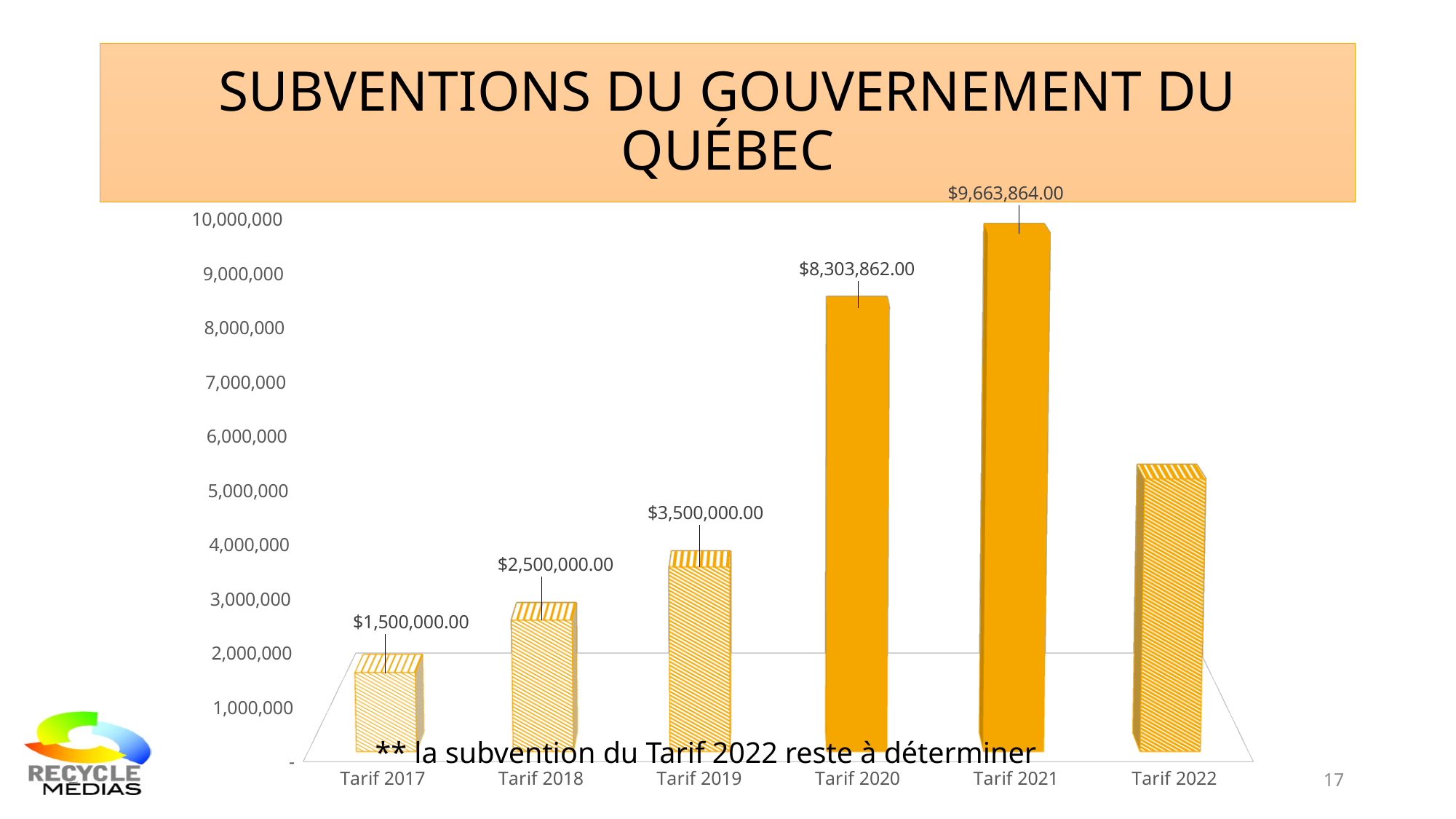
Which is larger, the value for Tarif 2019 or the value for Tarif 2020? Tarif 2020 What is the difference between the values for Tarif 2021 and Tarif 2020? $1,360,002.00 Which category has the highest value? Tarif 2021 Is the value for Tarif 2022 greater or less than 4,000,000? greater What is the value for Tarif 2020? $8,303,862.00 How many categories are shown on the x axis? 6 Do the values rise or fall from Tarif 2017 to Tarif 2021? rise Which category has the lowest value? Tarif 2017 What kind of chart is shown on the slide? bar chart What is the value for Tarif 2018? $2,500,000.00 What is the difference between the values for Tarif 2019 and Tarif 2017? $2,000,000.00 What is the value for Tarif 2021? $9,663,864.00